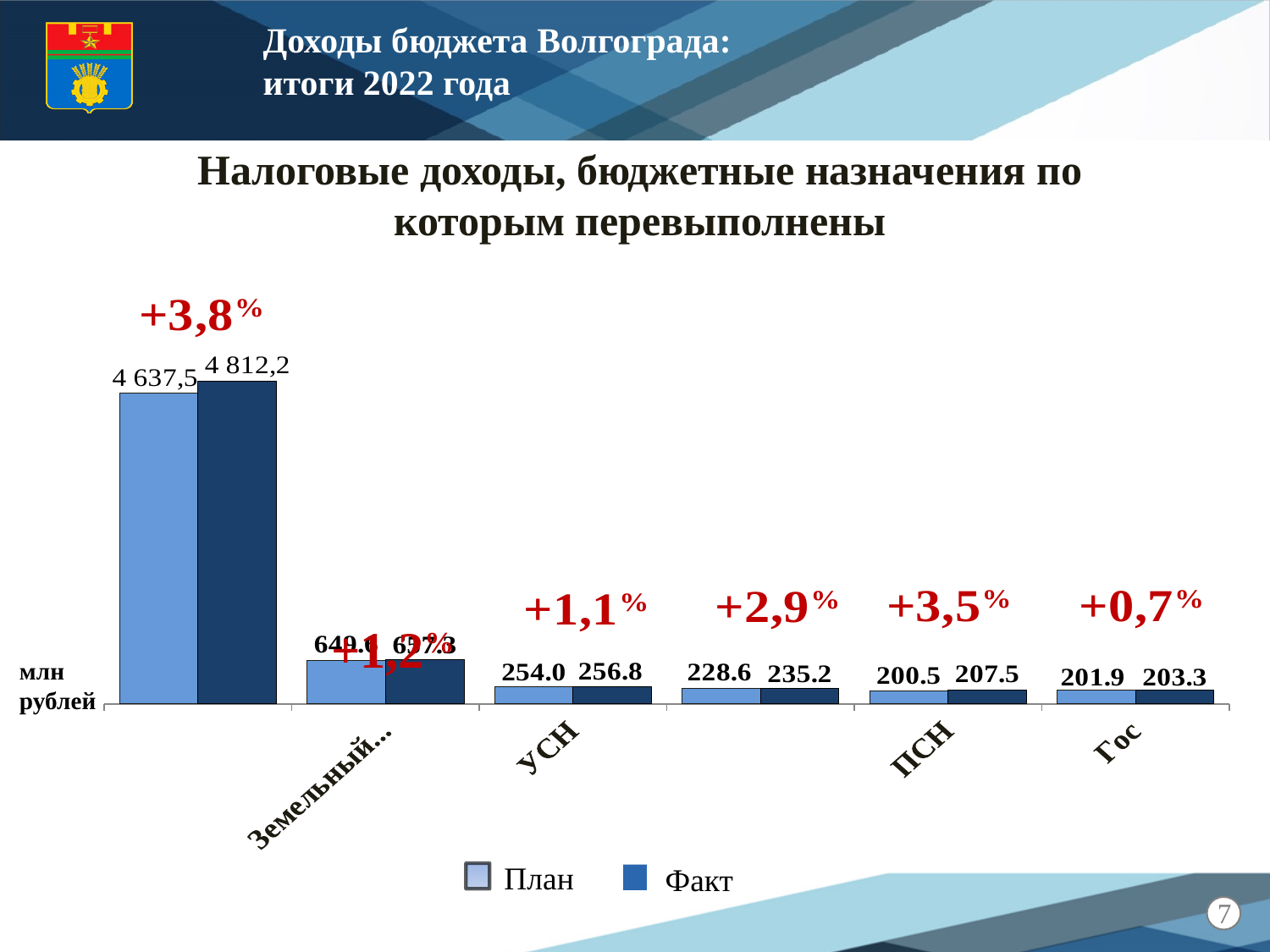
What kind of chart is shown on the slide? Bar chart What is the highest Факт value shown on the chart? 4 812,2 Which category has the lowest План value? ПСН How many series does the legend list? 2 What is the Факт value for ПСН? 207.5 What is the Факт value for Гос? 203.3 What is the difference between the Факт and План values for ПСН? 7.0 Which is larger, the Факт value for ПСН or the Факт value for Гос? ПСН What percentage increase is shown above the УСН bars? +1,1% What percentage increase is shown above the ПСН bars? +3,5% What is the difference between the Факт and План values for УСН? 2.8 What is the План value for УСН? 254.0